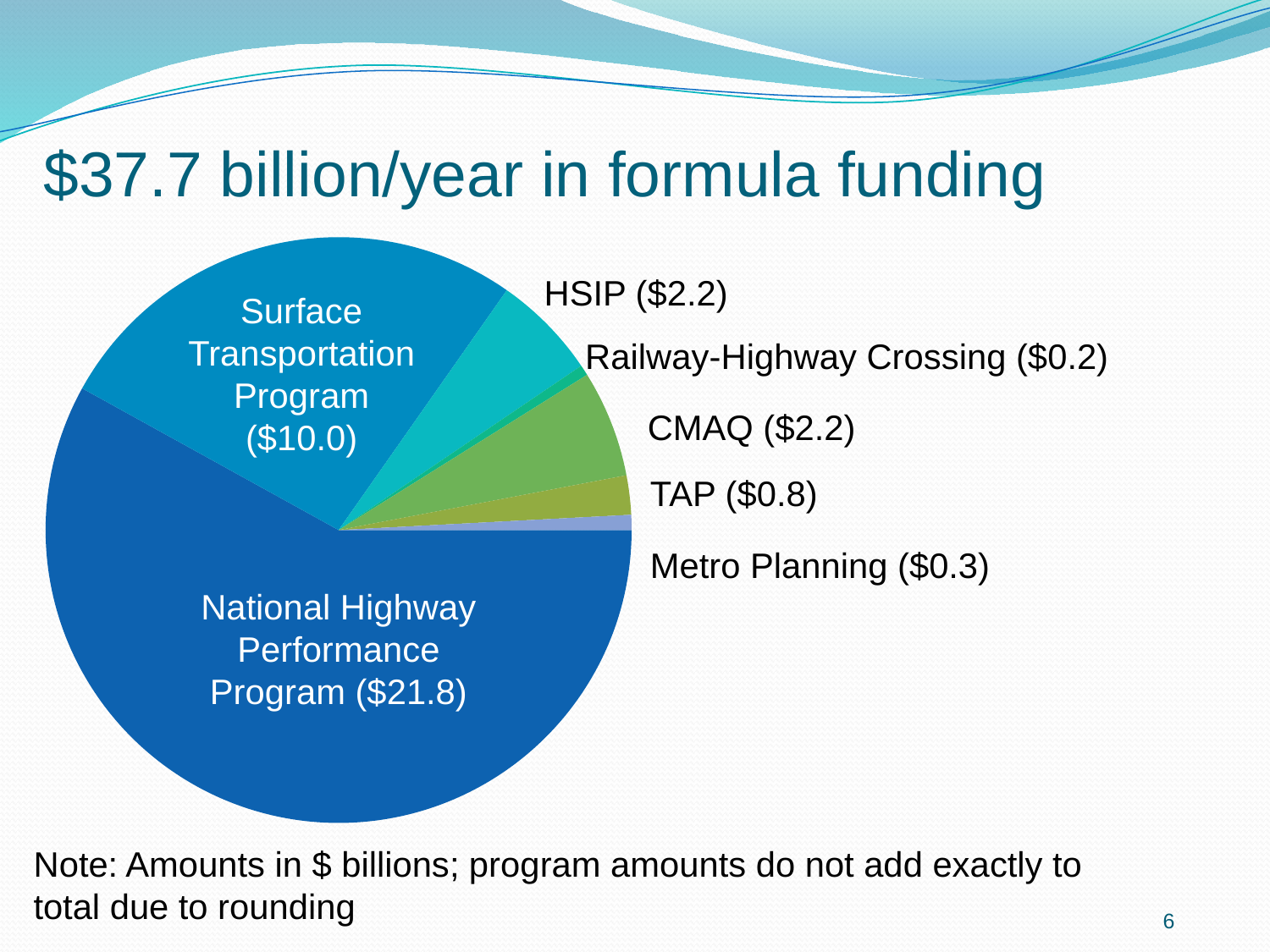
What is the title of the slide containing the pie chart? $37.7 billion/year in formula funding Which program receives the smallest amount of formula funding? Railway-Highway Crossing What is the amount for the Surface Transportation Program? $10.0 What is the amount for HSIP? $2.2 What type of chart is shown on the slide? Pie chart Which program receives the largest amount of formula funding? National Highway Performance Program What is the amount for the National Highway Performance Program? $21.8 Which is larger, the amount for CMAQ or the amount for TAP? CMAQ What is the amount for TAP? $0.8 What is the difference between the National Highway Performance Program and the Surface Transportation Program amounts? $11.8 How many programs are shown in the pie chart? 7 What is the amount for Metro Planning? $0.3